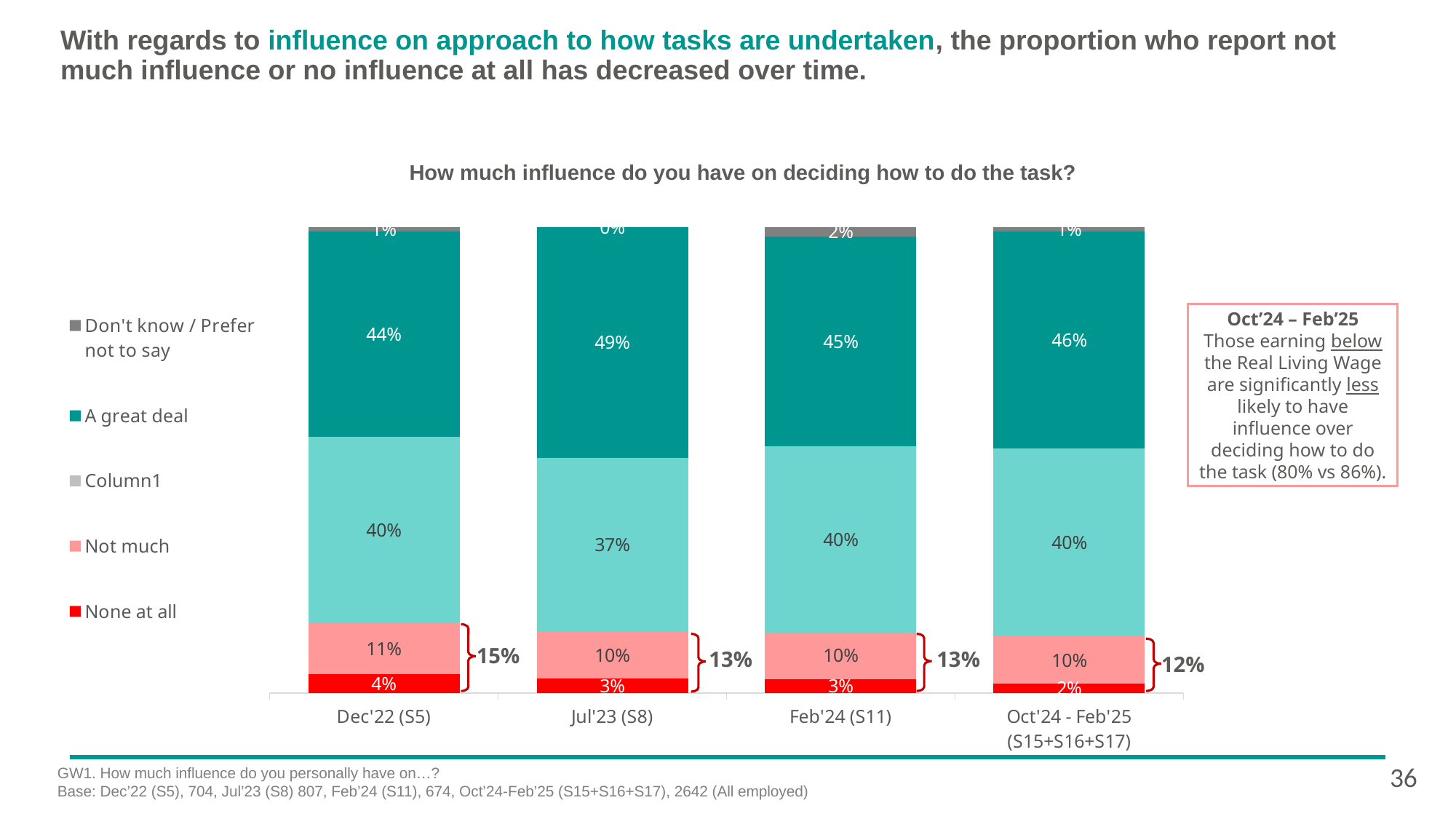
In which period was the 'A great deal' share highest? Jul'23 (S8) What is the title of the chart? How much influence do you have on deciding how to do the task? In which period was the 'None at all' share lowest? Oct'24 - Feb'25 (S15+S16+S17) How many time periods (categories) are shown on the x axis? 4 What percentage reported 'Not much' influence in Oct'24 - Feb'25 (S15+S16+S17)? 10% How many series does the legend list? 5 What is the combined 'Not much' and 'None at all' share shown by the bracket for Dec'22 (S5)? 15% What type of chart is shown on the slide? Stacked bar chart What is the difference between the 'A great deal' share in Jul'23 (S8) and in Dec'22 (S5)? 5 percentage points Does the combined 'Not much' / 'None at all' share (bracket values) rise or fall from Dec'22 to Oct'24 - Feb'25? Fall What percentage reported 'None at all' in Dec'22 (S5)? 4% What percentage reported 'A great deal' of influence in Jul'23 (S8)? 49%